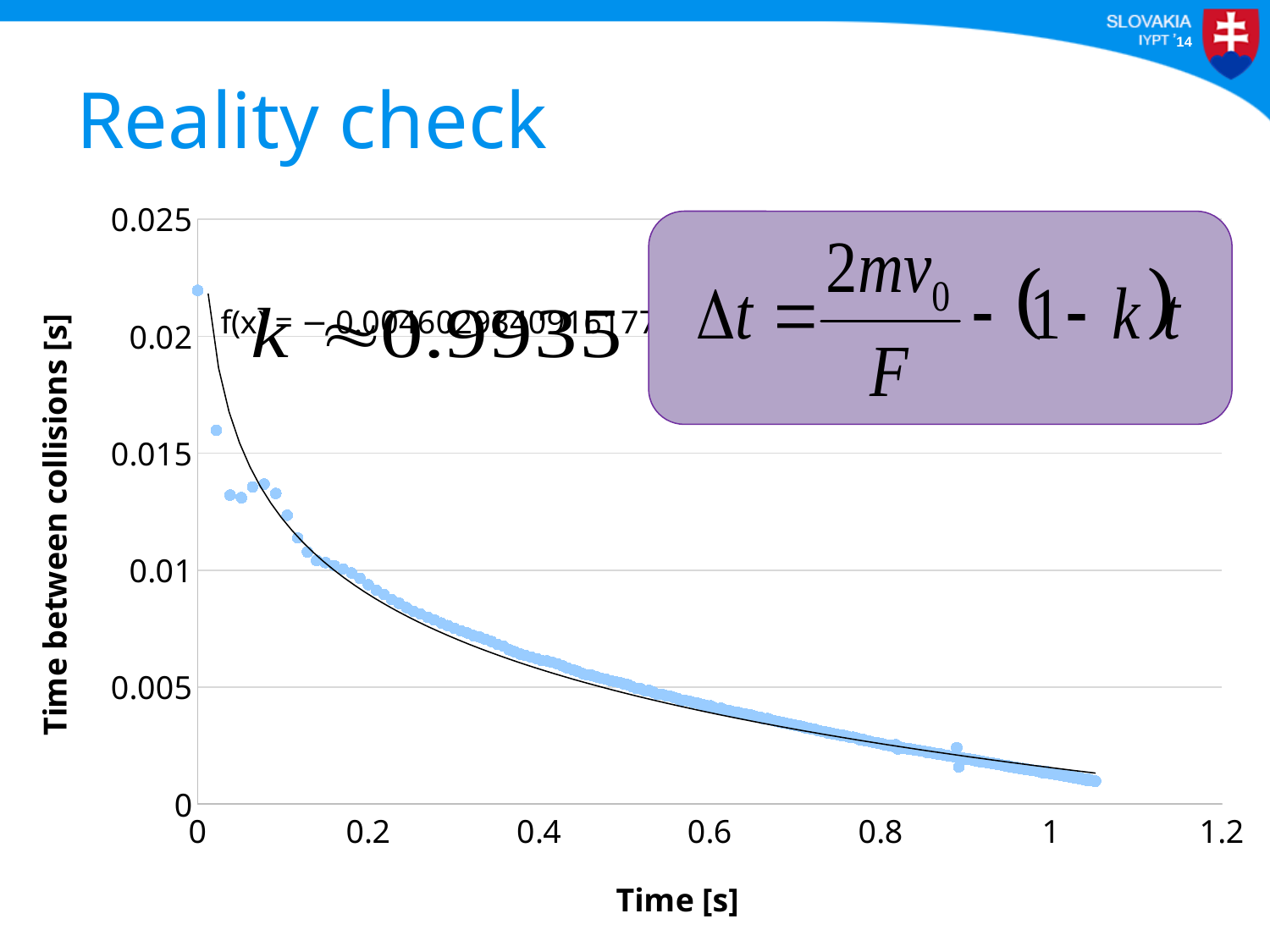
Is the time between collisions at time 0.8 s greater or less than 0.005? less What is the highest value shown on the y axis? 0.025 Do the plotted values rise or fall as time increases along the x axis? fall Is the time between collisions at time 0.4 s greater or less than 0.01? less Is the time between collisions at time 0 s greater or less than 0.02? greater What is the label of the y axis? Time between collisions [s] Which is larger, the time between collisions at 0.2 s or at 0.8 s? at 0.2 s What kind of chart is shown on the slide? scatter chart What is the label of the x axis? Time [s]